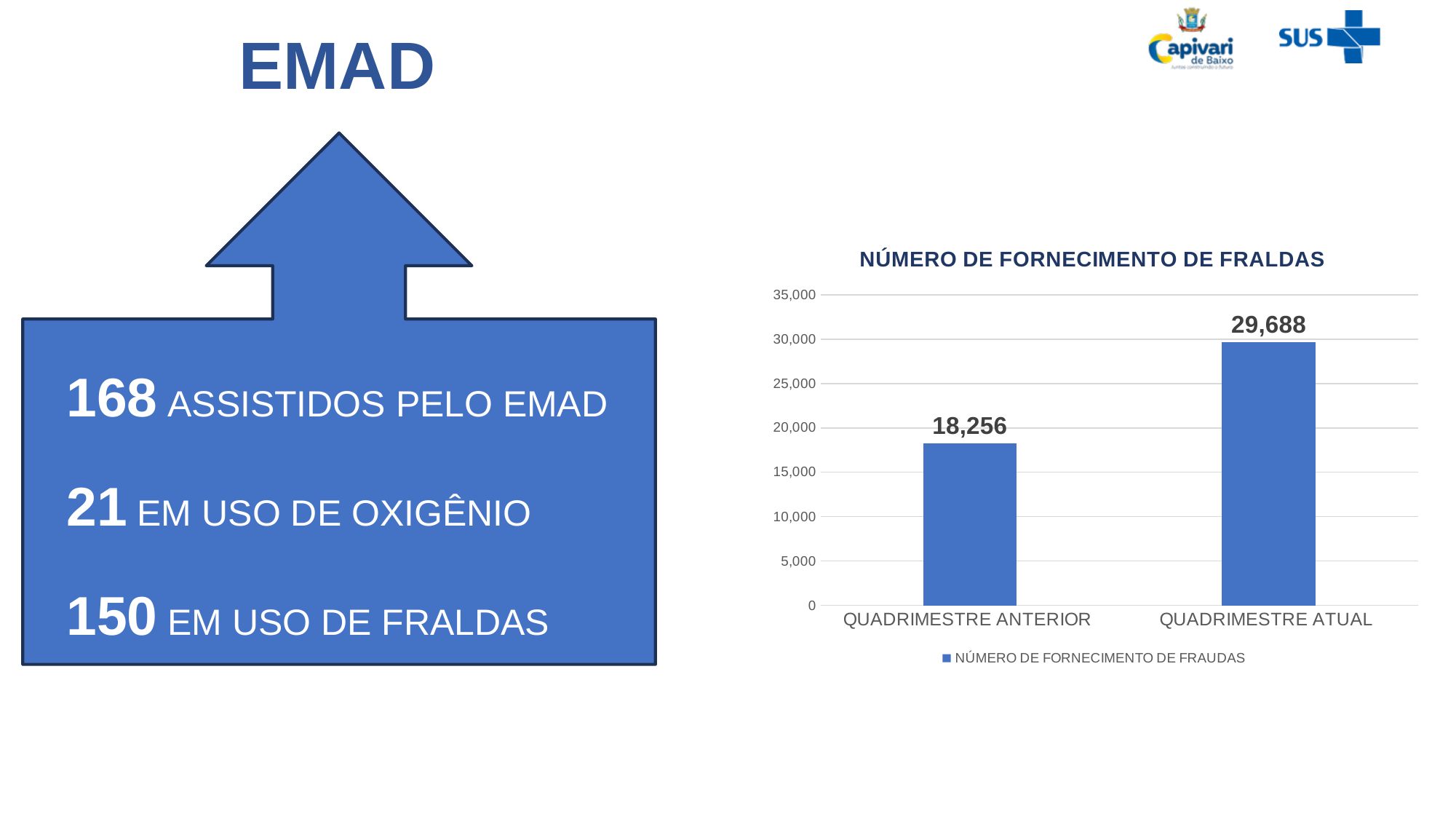
Is the value for QUADRIMESTRE ATUAL greater or less than 25,000? greater Which is larger, the value for QUADRIMESTRE ANTERIOR or QUADRIMESTRE ATUAL? QUADRIMESTRE ATUAL Is the value for QUADRIMESTRE ANTERIOR greater or less than 20,000? less How many categories are shown on the x axis? 2 Which category has the highest value? QUADRIMESTRE ATUAL What is the value for QUADRIMESTRE ANTERIOR? 18,256 How many series does the legend list? 1 What is the difference between the values for QUADRIMESTRE ATUAL and QUADRIMESTRE ANTERIOR? 11,432 What kind of chart is shown? bar chart Which category has the lowest value? QUADRIMESTRE ANTERIOR What is the value for QUADRIMESTRE ATUAL? 29,688 What is the title of the chart? NÚMERO DE FORNECIMENTO DE FRALDAS